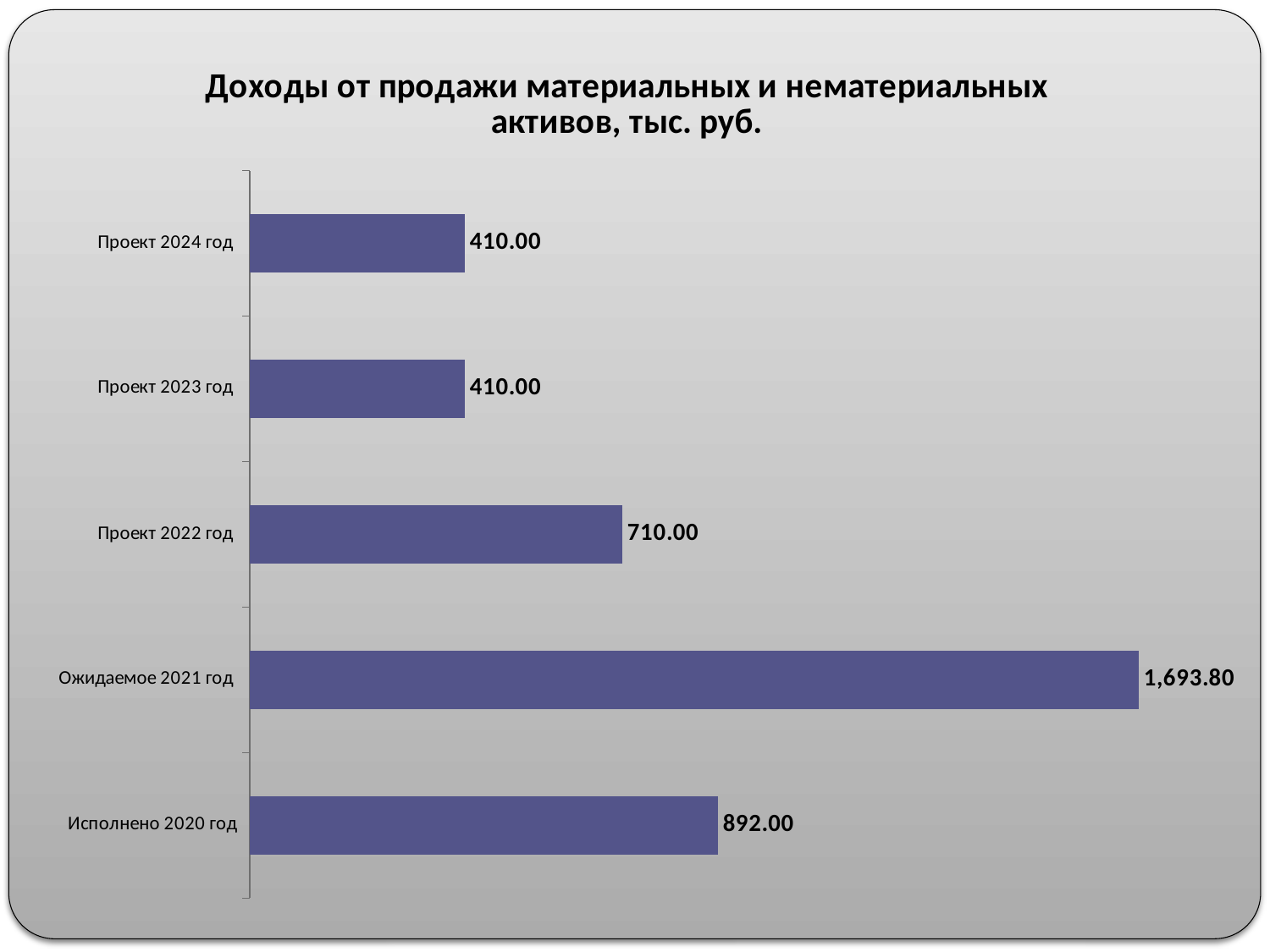
What is the value for Ожидаемое 2021 год? 1,693.80 What is the value for Проект 2022 год? 710.00 Which is larger, the value for Исполнено 2020 год or the value for Проект 2022 год? Исполнено 2020 год What is the difference between the values for Ожидаемое 2021 год and Исполнено 2020 год? 801.80 What kind of chart is shown on the slide? Bar chart What is the value for Исполнено 2020 год? 892.00 Which category has the highest value? Ожидаемое 2021 год Do the values for Проект 2023 год and Проект 2024 год differ? No, both are 410.00 How many categories are shown in the chart? 5 What is the title of the chart? Доходы от продажи материальных и нематериальных активов, тыс. руб. What is the value for Проект 2024 год? 410.00 What is the difference between the values for Проект 2022 год and Проект 2023 год? 300.00